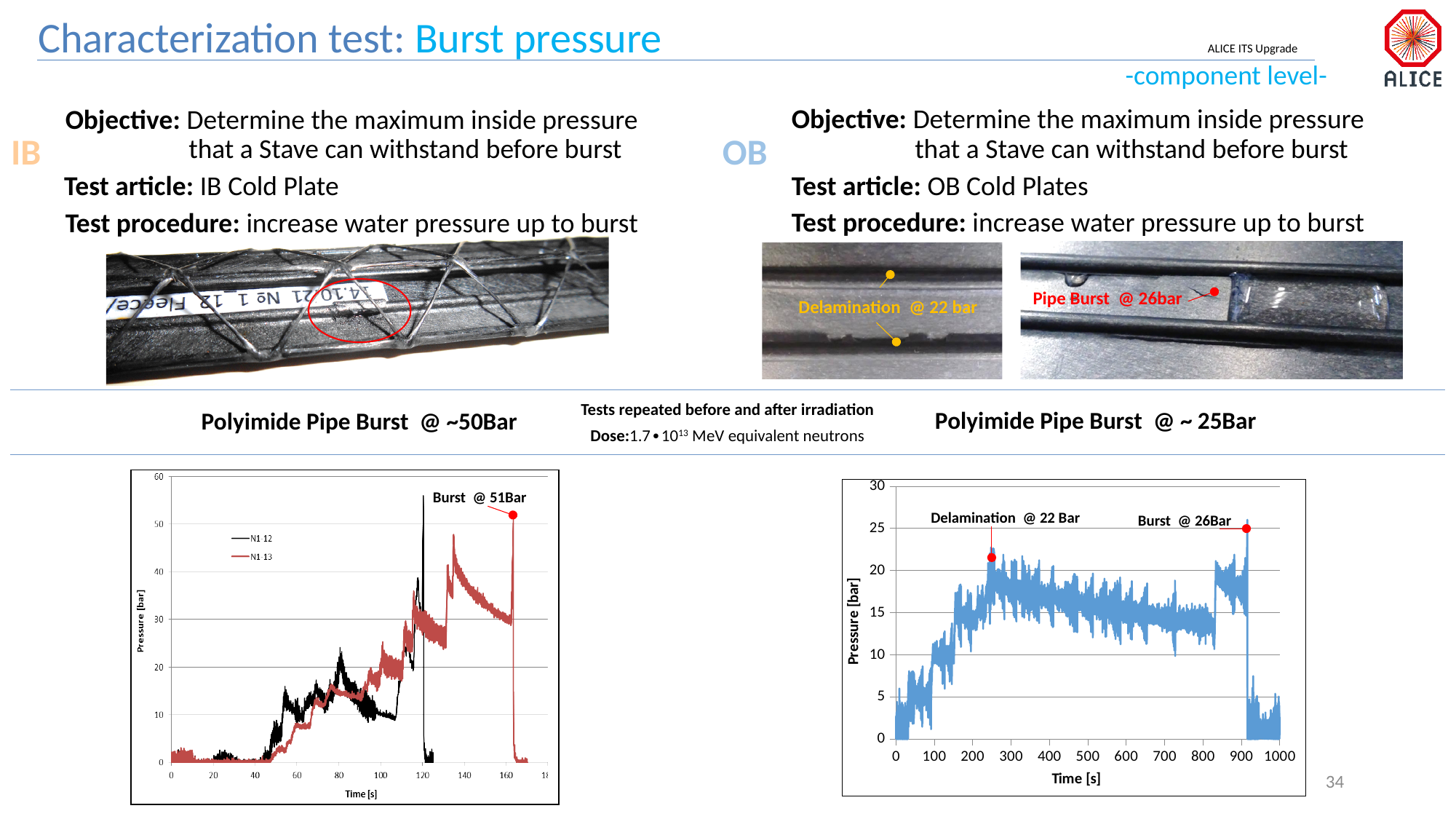
Which chart shows the higher annotated burst pressure, the left chart or the right chart? the left chart On the right chart, at what pressure does the annotated delamination occur? 22 Bar On the left chart, at what pressure does the annotated burst occur? 51Bar What is the difference between the annotated burst pressure on the left chart and the annotated burst pressure on the right chart? 25 bar How many series does the legend of the left chart list? 2 On the right chart, is the pressure at 500 s greater or less than 20 bar? less What kind of chart is the left chart (IB burst test)? line chart What are the two series named in the legend of the left chart? N1 12 and N1 13 On the right chart, what is the difference between the annotated burst pressure and the annotated delamination pressure? 4 bar What is the y-axis label of the left chart? Pressure [bar] On the right chart, at what pressure does the annotated burst occur? 26Bar What kind of chart is the right chart (OB burst test)? line chart